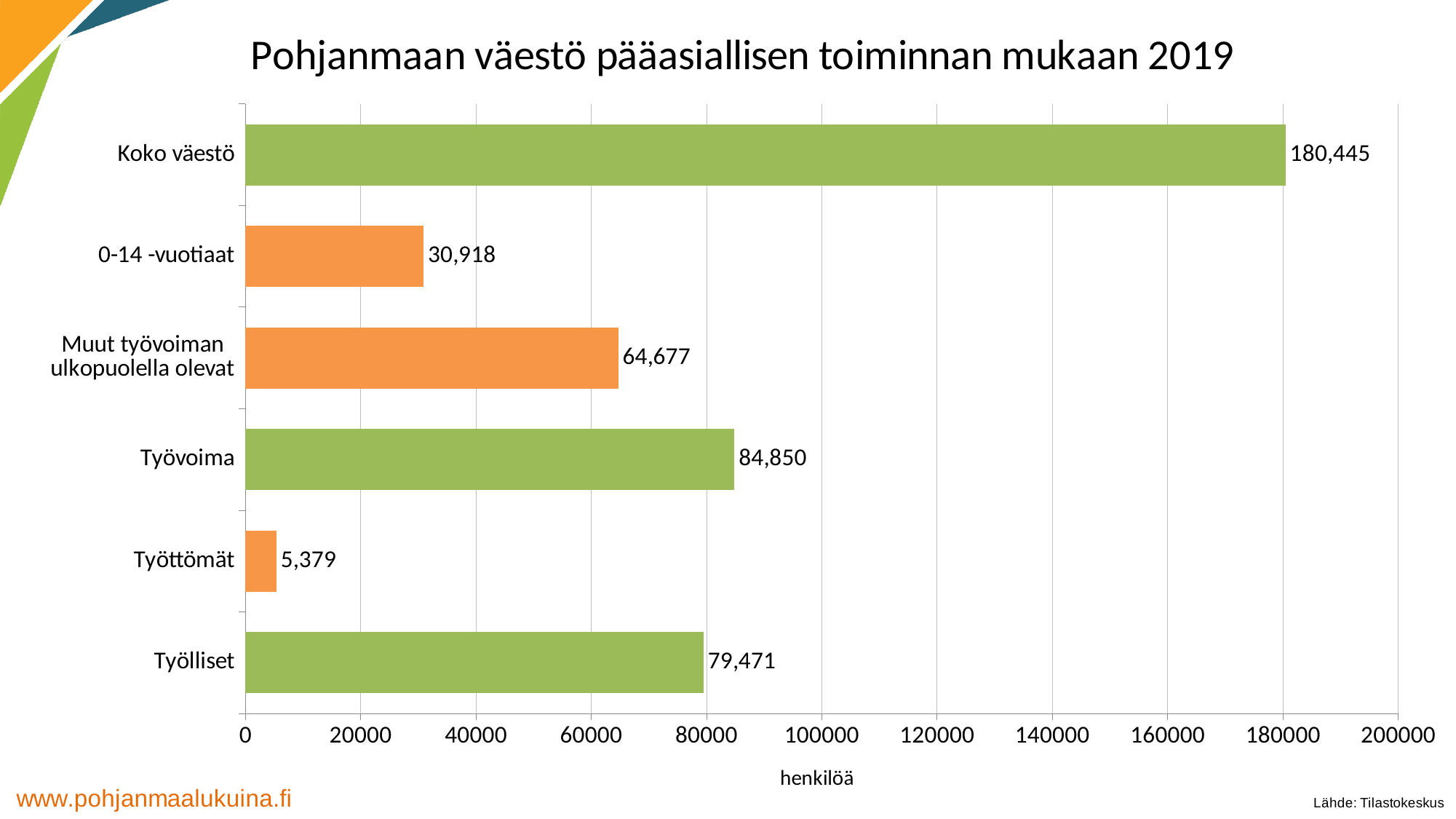
What is the title of the chart? Pohjanmaan väestö pääasiallisen toiminnan mukaan 2019 Which is larger, Työvoima or Muut työvoiman ulkopuolella olevat? Työvoima How many categories are shown in the chart? 6 Which category has the highest value? Koko väestö Which category has the lowest value? Työttömät What is the value for Työttömät? 5,379 What is the difference between Työvoima and Työlliset? 5,379 What kind of chart is shown on the slide? Bar chart What is the difference between Muut työvoiman ulkopuolella olevat and 0-14 -vuotiaat? 33,759 What is the value for Koko väestö? 180,445 What is the value for Muut työvoiman ulkopuolella olevat? 64,677 Is the value for Työlliset greater or less than 80000? less